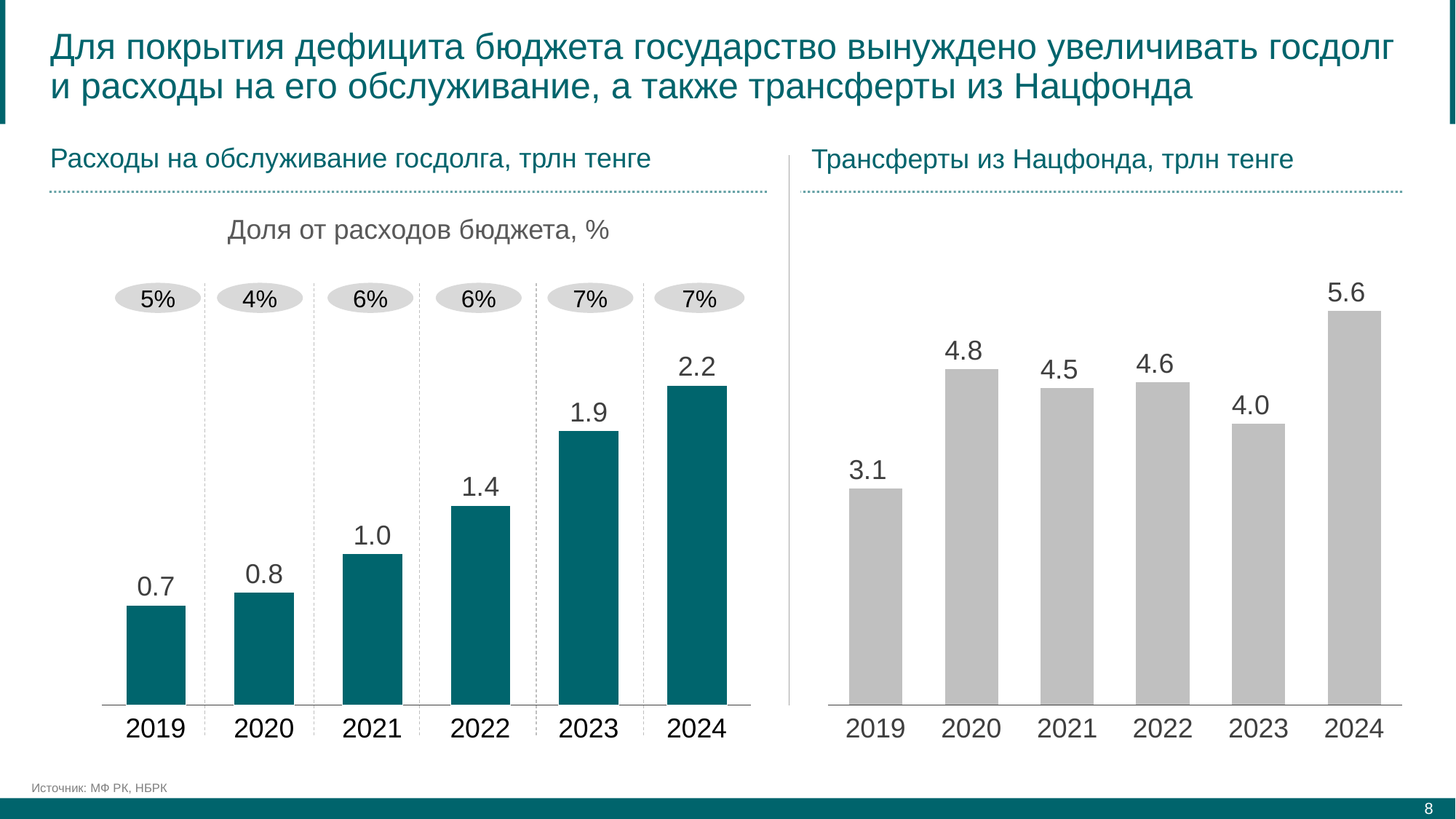
How many years are shown on the x axis of the chart 'Расходы на обслуживание госдолга, трлн тенге'? 6 In the chart 'Трансферты из Нацфонда, трлн тенге', what is the value for 2023? 4.0 What colour are the bars in the chart 'Трансферты из Нацфонда, трлн тенге'? grey In the chart 'Расходы на обслуживание госдолга, трлн тенге', what is the value for 2022? 1.4 In the chart 'Расходы на обслуживание госдолга, трлн тенге', do the values rise or fall from 2019 to 2024? rise What kind of chart is 'Трансферты из Нацфонда, трлн тенге'? bar chart In the chart 'Трансферты из Нацфонда, трлн тенге', what is the difference between the values for 2024 and 2023? 1.6 In the chart 'Трансферты из Нацфонда, трлн тенге', which year has the lowest value? 2019 In the chart 'Расходы на обслуживание госдолга, трлн тенге', which year has the highest value? 2024 In the chart 'Трансферты из Нацфонда, трлн тенге', which is larger, the value for 2020 or the value for 2021? 2020 In the chart 'Расходы на обслуживание госдолга, трлн тенге', what is the difference between the values for 2024 and 2019? 1.5 In the chart 'Расходы на обслуживание госдолга, трлн тенге', what share of budget expenditures ('Доля от расходов бюджета, %') is shown for 2021? 6%